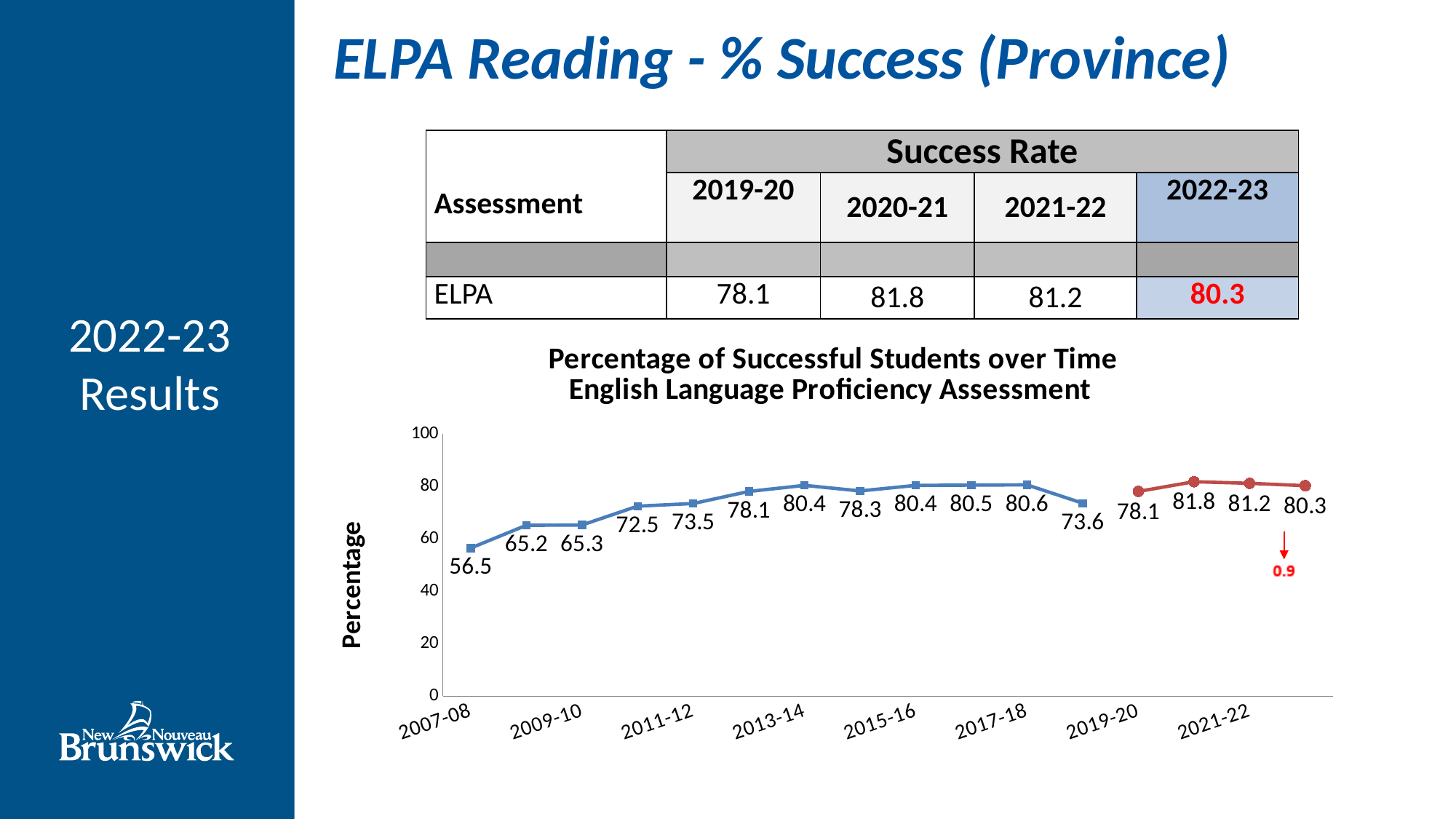
By how much did the percentage of successful students drop from 2021-22 to 2022-23? 0.9 How many data points are plotted on the line chart? 16 What type of chart is shown on the slide? line chart What is the percentage of successful students for 2007-08? 56.5 Which year has the highest percentage of successful students? 2020-21 What is the percentage of successful students for 2017-18? 80.6 Which year has the lowest percentage of successful students? 2007-08 What is the percentage of successful students for 2022-23? 80.3 What is the percentage of successful students for 2013-14? 80.4 What is the title of the y axis on the chart? Percentage What is the difference between the 2017-18 value and the 2007-08 value? 24.1 Which year has a higher percentage of successful students, 2011-12 or 2015-16? 2015-16